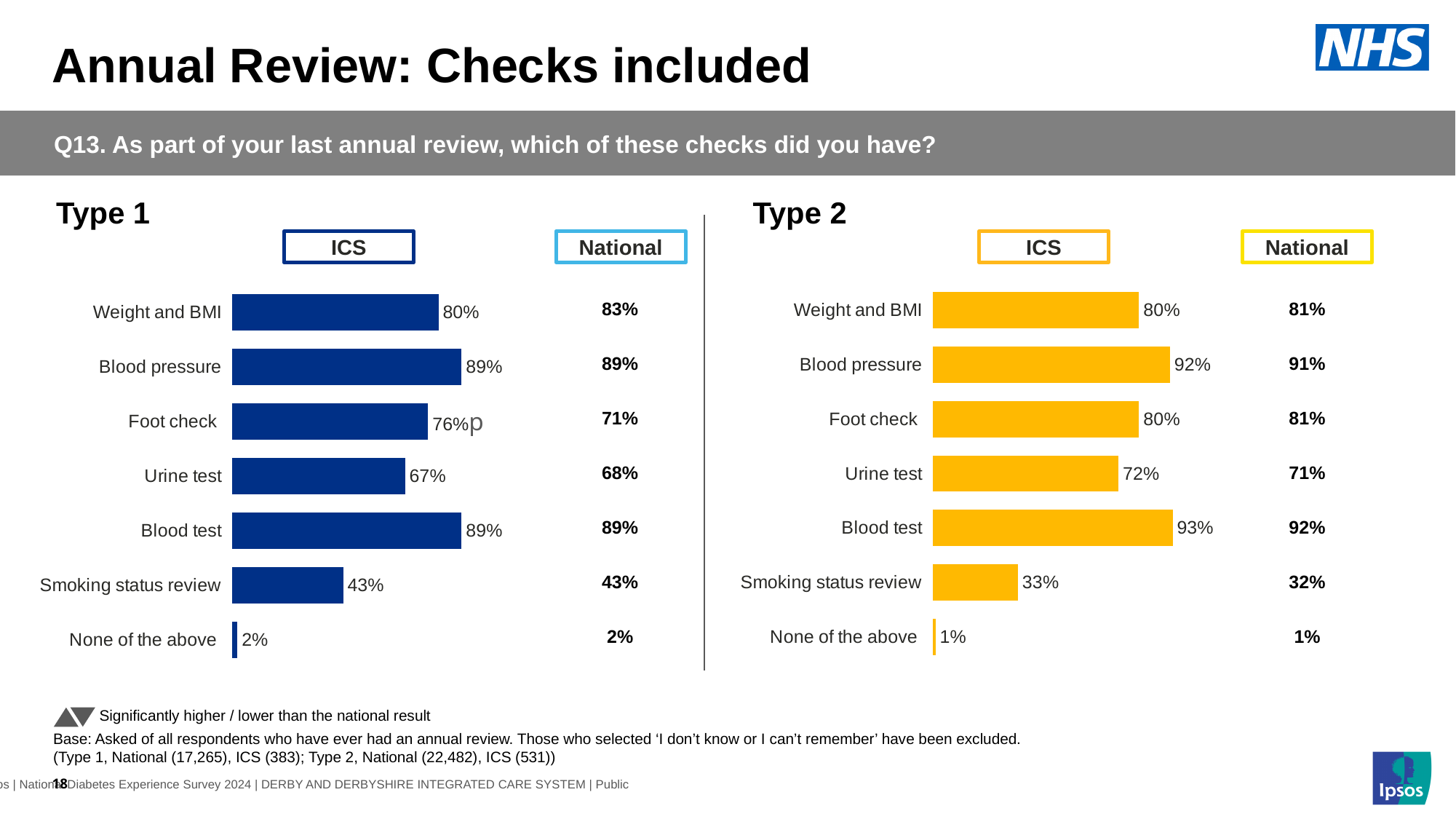
In the Type 2 chart, what is the ICS value for Blood test? 93% In the Type 1 chart, which is larger: the ICS value for Urine test or the ICS value for Smoking status review? Urine test In the Type 2 chart, which check has the highest ICS value? Blood test In the Type 2 chart, what is the National value for Smoking status review? 32% In the Type 1 chart, what is the National value for Weight and BMI? 83% In the Type 1 chart, what is the ICS value for Foot check? 76% In the Type 1 chart, which category has the lowest ICS value? None of the above What colour are the ICS bars in the Type 2 chart? Yellow What type of chart is used for the Type 1 ICS results? Bar chart How many checks (categories) are listed in the Type 2 chart? 7 In the Type 1 chart, what is the difference between the ICS and National values for Foot check? 5% In the Type 2 chart, what is the difference between the ICS values for Blood pressure and Urine test? 20%